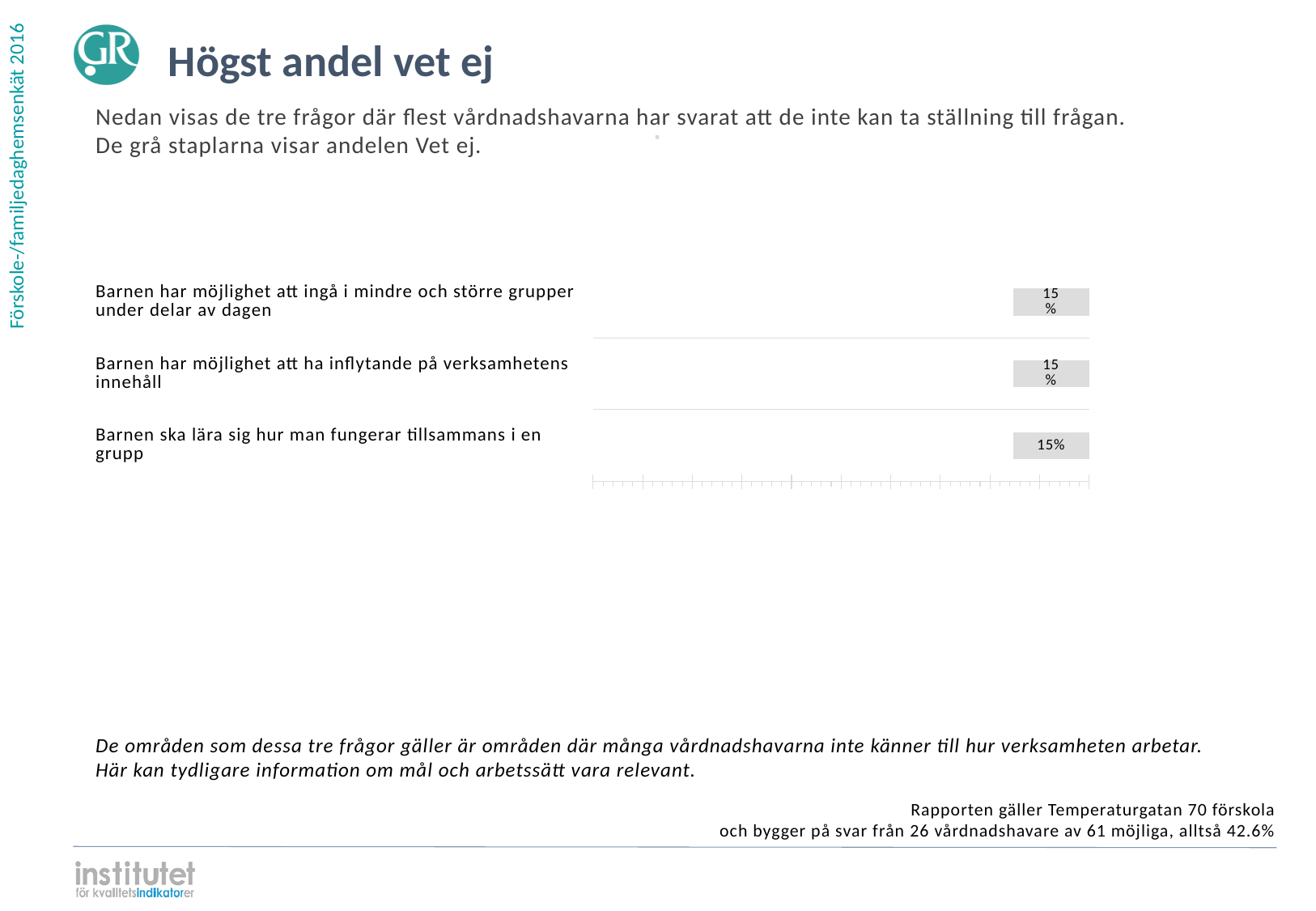
What is the title of the slide containing the chart? Högst andel vet ej What is the value for "Barnen har möjlighet att ingå i mindre och större grupper under delar av dagen"? 15% What kind of chart is shown on the slide? Bar chart What colour are the bars in the chart? Grey Do all three categories in the chart have the same value? Yes How many categories are shown in the chart? 3 What is the value for "Barnen har möjlighet att ha inflytande på verksamhetens innehåll"? 15% Is the value for "Barnen ska lära sig hur man fungerar tillsammans i en grupp" greater or less than 50%? less What is the difference between the value for "Barnen har möjlighet att ha inflytande på verksamhetens innehåll" and the value for "Barnen ska lära sig hur man fungerar tillsammans i en grupp"? 0% What is the value for "Barnen ska lära sig hur man fungerar tillsammans i en grupp"? 15%